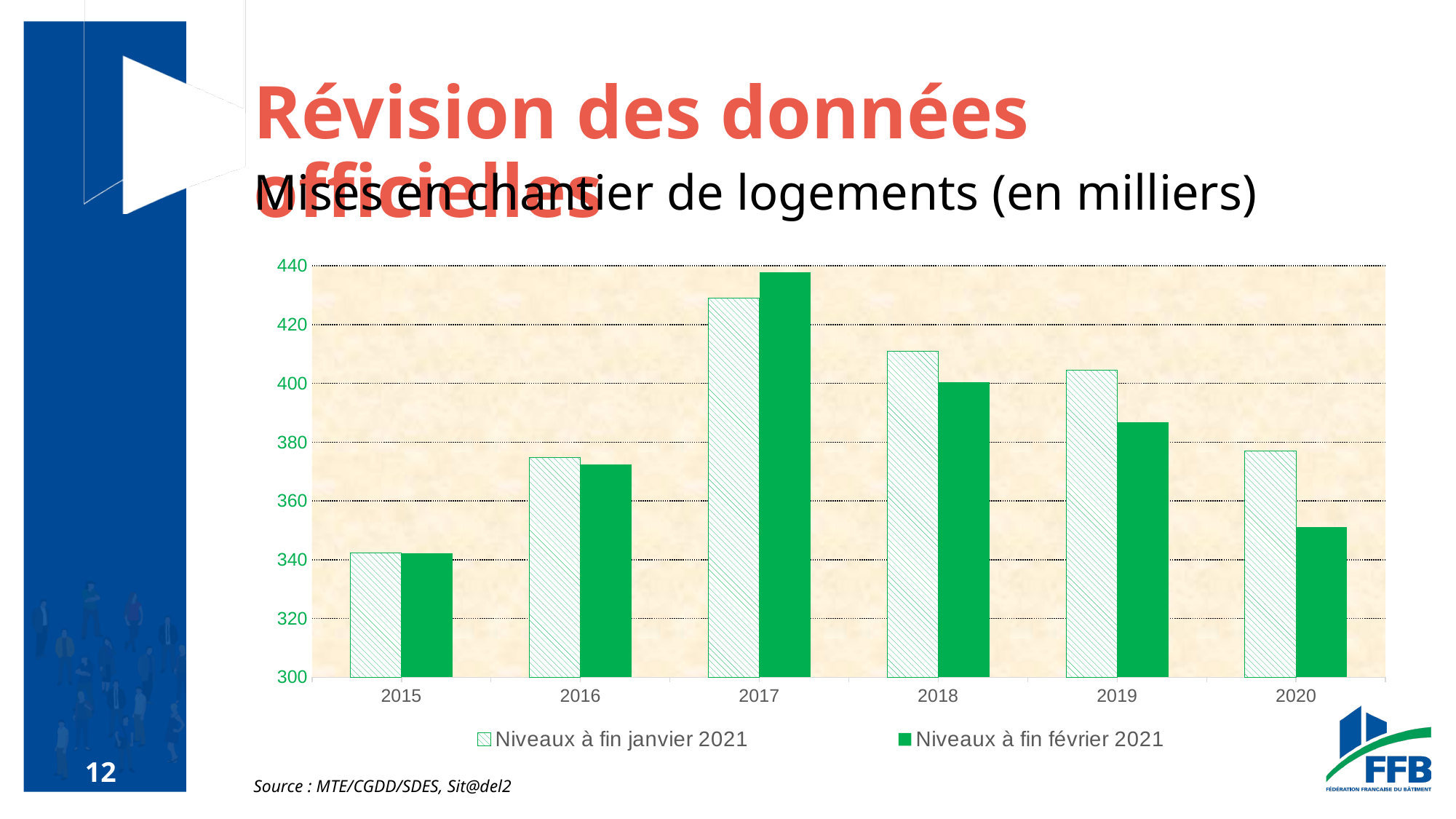
How many years are shown on the x axis? 6 Do the values for 'Niveaux à fin février 2021' rise or fall from 2017 to 2020? fall In 2018, which series has the larger value: 'Niveaux à fin janvier 2021' or 'Niveaux à fin février 2021'? Niveaux à fin janvier 2021 In 2017, which series has the larger value: 'Niveaux à fin janvier 2021' or 'Niveaux à fin février 2021'? Niveaux à fin février 2021 Is the value for 'Niveaux à fin février 2021' in 2020 greater or less than 360? less How many series does the legend list? 2 Is the value for 'Niveaux à fin janvier 2021' in 2018 greater or less than 400? greater Is the value for 'Niveaux à fin février 2021' in 2019 greater or less than 400? less What kind of chart is shown on the slide? bar chart Which year has the highest value for 'Niveaux à fin février 2021'? 2017 Which year has the lowest value for 'Niveaux à fin janvier 2021'? 2015